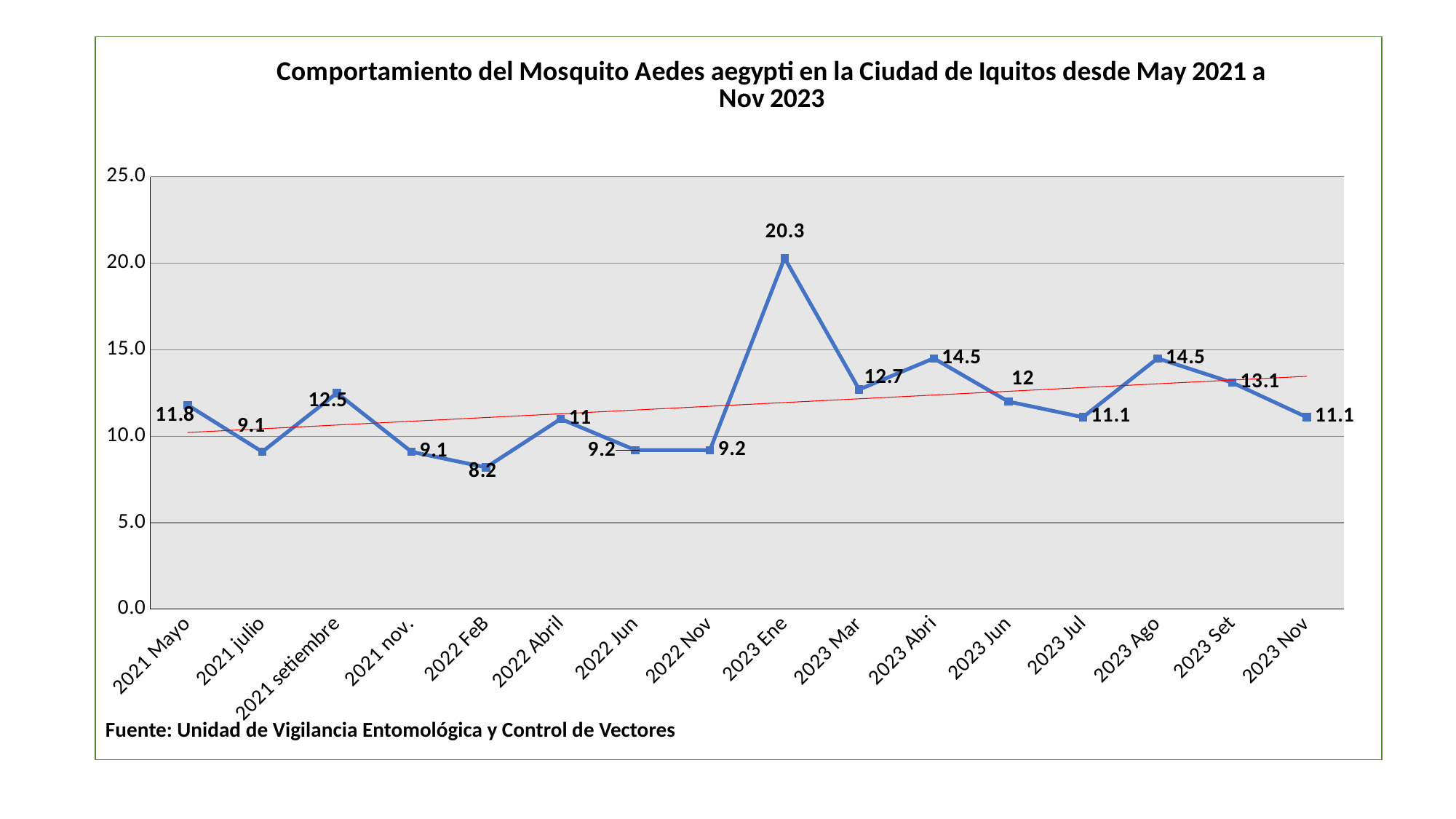
Is the value for 2023 Ene greater or less than 20.0? greater Which period has the highest value? 2023 Ene Which period has the lowest value? 2022 FeB What is the value for 2023 Ene? 20.3 What is the difference between the values for 2023 Ago and 2023 Jul? 3.4 What is the difference between the values for 2023 Ene and 2023 Mar? 7.6 How many data points are plotted on the chart? 16 What type of chart is shown on the slide? Line chart What is the value for 2022 FeB? 8.2 What is the value for 2021 setiembre? 12.5 Which is larger, the value for 2023 Set or the value for 2023 Nov? 2023 Set What is the title of the chart? Comportamiento del Mosquito Aedes aegypti en la Ciudad de Iquitos desde May 2021 a Nov 2023